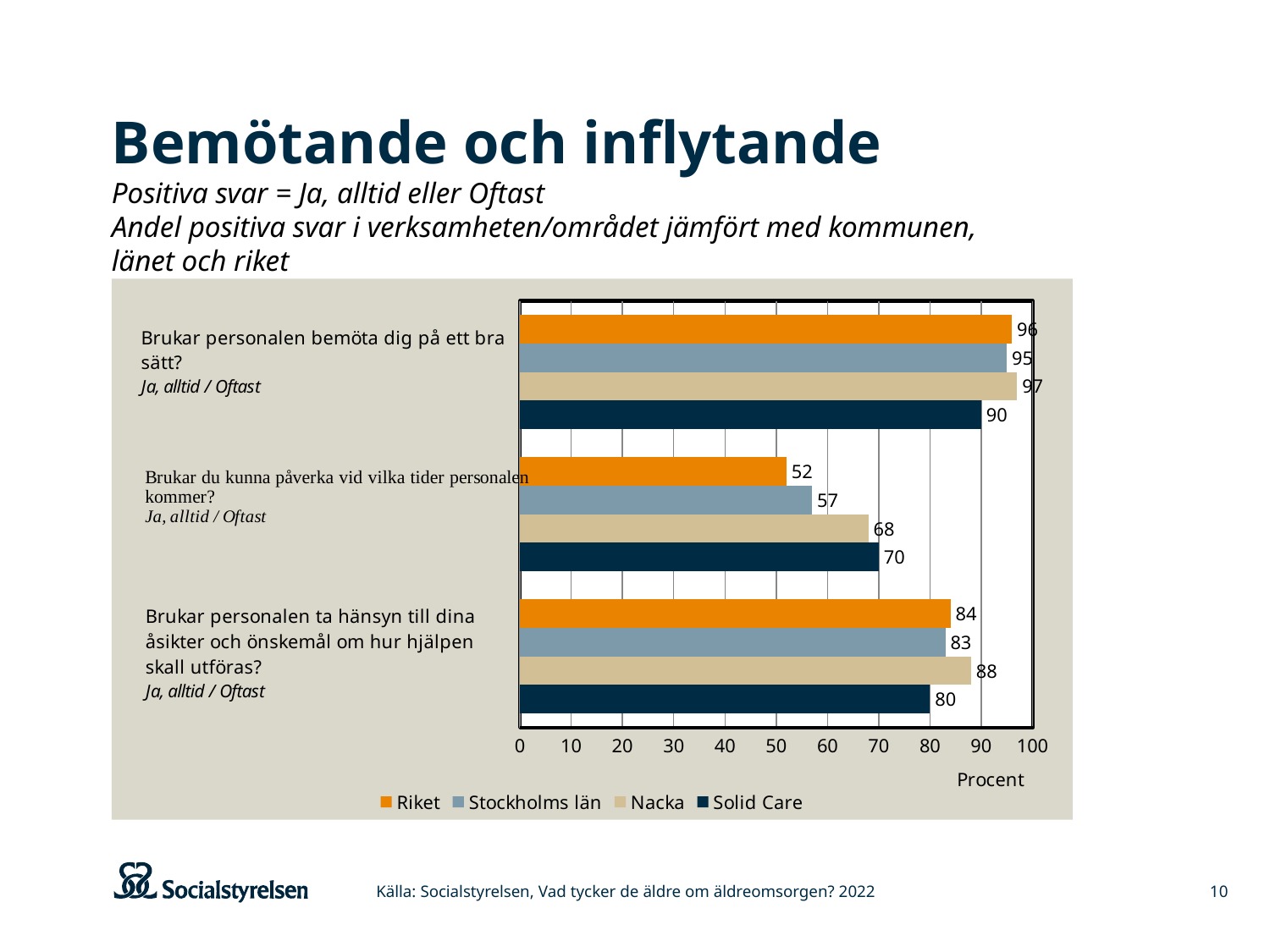
What kind of chart is shown on the slide? bar chart What is the value for Riket on "Brukar personalen ta hänsyn till dina åsikter och önskemål om hur hjälpen skall utföras?" 84 What is the difference between Solid Care and Riket on "Brukar du kunna påverka vid vilka tider personalen kommer?" 18 Which is larger on "Brukar personalen ta hänsyn till dina åsikter och önskemål om hur hjälpen skall utföras?": Nacka or Solid Care? Nacka Which series has the highest value on "Brukar personalen ta hänsyn till dina åsikter och önskemål om hur hjälpen skall utföras?" Nacka What label is shown on the horizontal axis of the chart? Procent How many question categories are plotted on the chart? 3 Is the value for Stockholms län on "Brukar du kunna påverka vid vilka tider personalen kommer?" greater or less than 60? less What is the value for Nacka on "Brukar du kunna påverka vid vilka tider personalen kommer?" 68 How many series does the legend list? 4 Which series has the lowest value on "Brukar du kunna påverka vid vilka tider personalen kommer?" Riket What is the value for Solid Care on "Brukar personalen bemöta dig på ett bra sätt?" 90